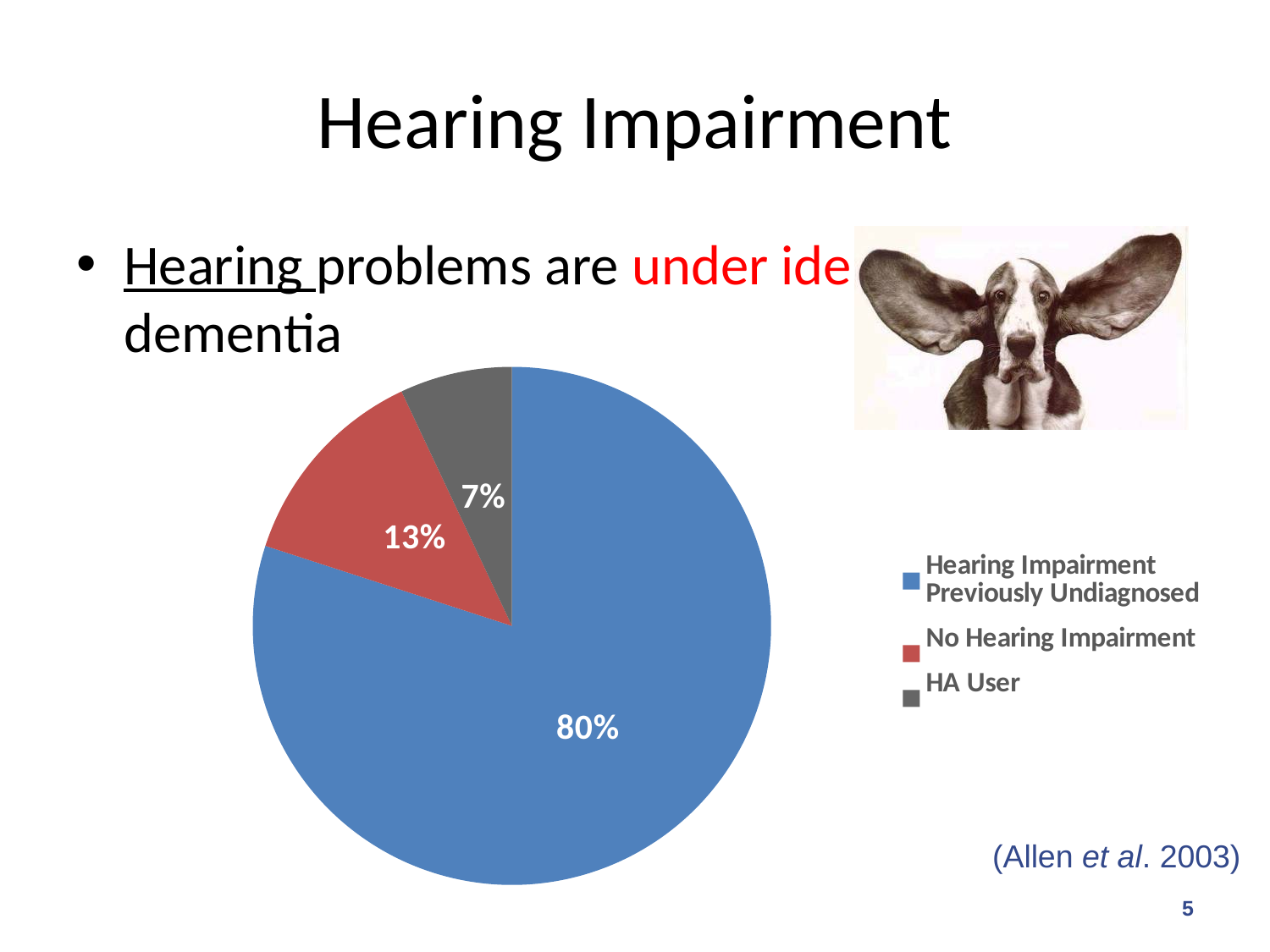
Which category has the smallest slice of the pie? HA User What share of the pie is labelled Hearing Impairment Previously Undiagnosed? 80% How many entries does the legend list? 3 What colour is the HA User slice? grey Which category has the largest slice of the pie? Hearing Impairment Previously Undiagnosed What share of the pie is labelled No Hearing Impairment? 13% What share of the pie is labelled HA User? 7% How many slices does the pie chart have? 3 What colour is the slice for Hearing Impairment Previously Undiagnosed? blue Which slice is larger: No Hearing Impairment or HA User? No Hearing Impairment What kind of chart is shown on the slide? pie chart What is the difference in percentage points between the No Hearing Impairment slice and the HA User slice? 6%